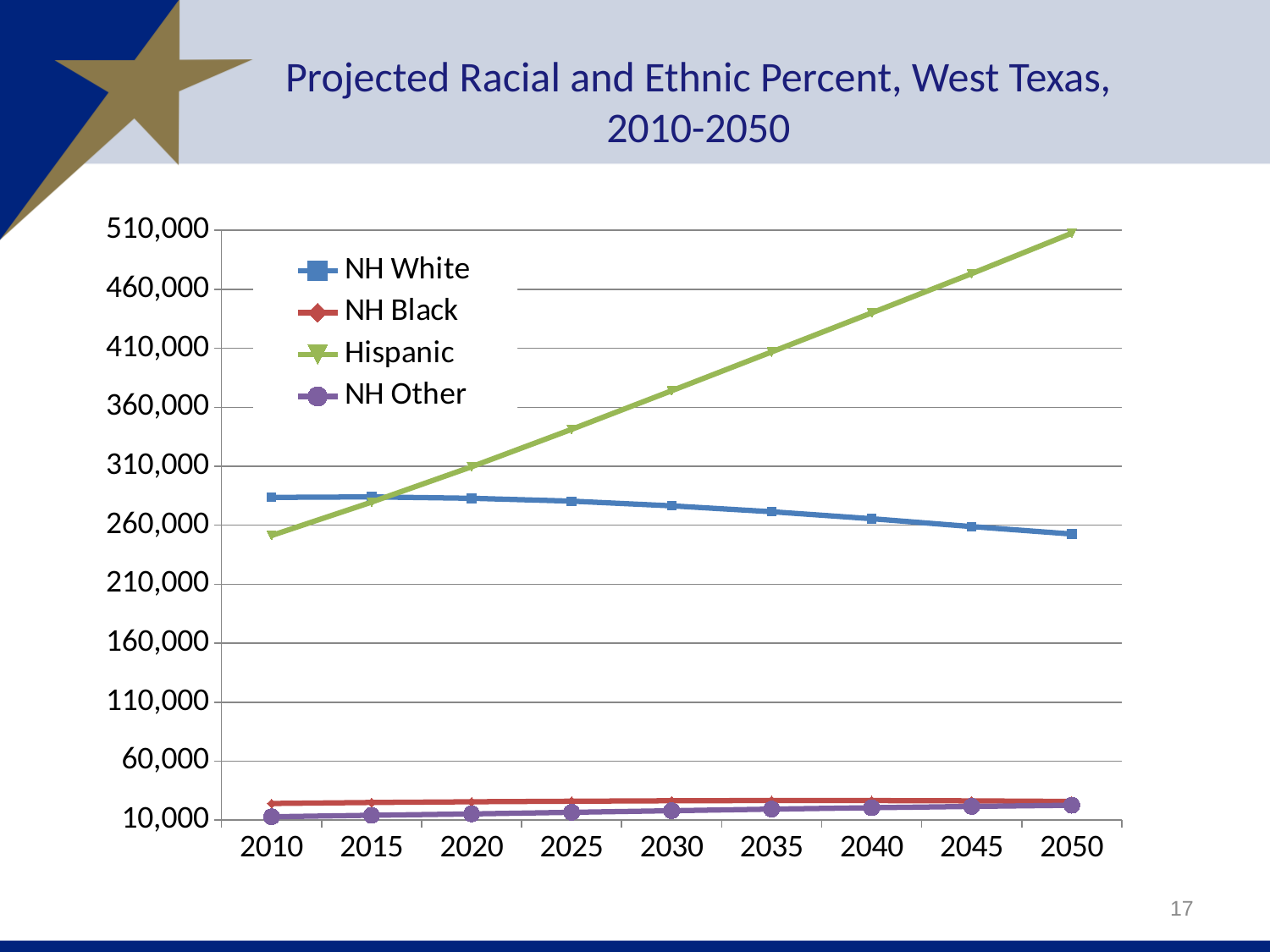
In 2050, which is larger: NH White or Hispanic? Hispanic Which series has the lowest value in 2010? NH Other Is the value for Hispanic in 2050 greater or less than 460,000? greater What kind of chart is shown on the slide? line chart In 2010, which is larger: NH White or Hispanic? NH White Is the value for Hispanic in 2030 greater or less than 360,000? greater Which series has the highest value in 2050? Hispanic How many years are plotted along the x axis? 9 How many series does the legend list? 4 What is the title of the chart? Projected Racial and Ethnic Percent, West Texas, 2010-2050 Does the Hispanic line rise or fall from 2010 to 2050? rises Does the NH White line rise or fall from 2010 to 2050? falls